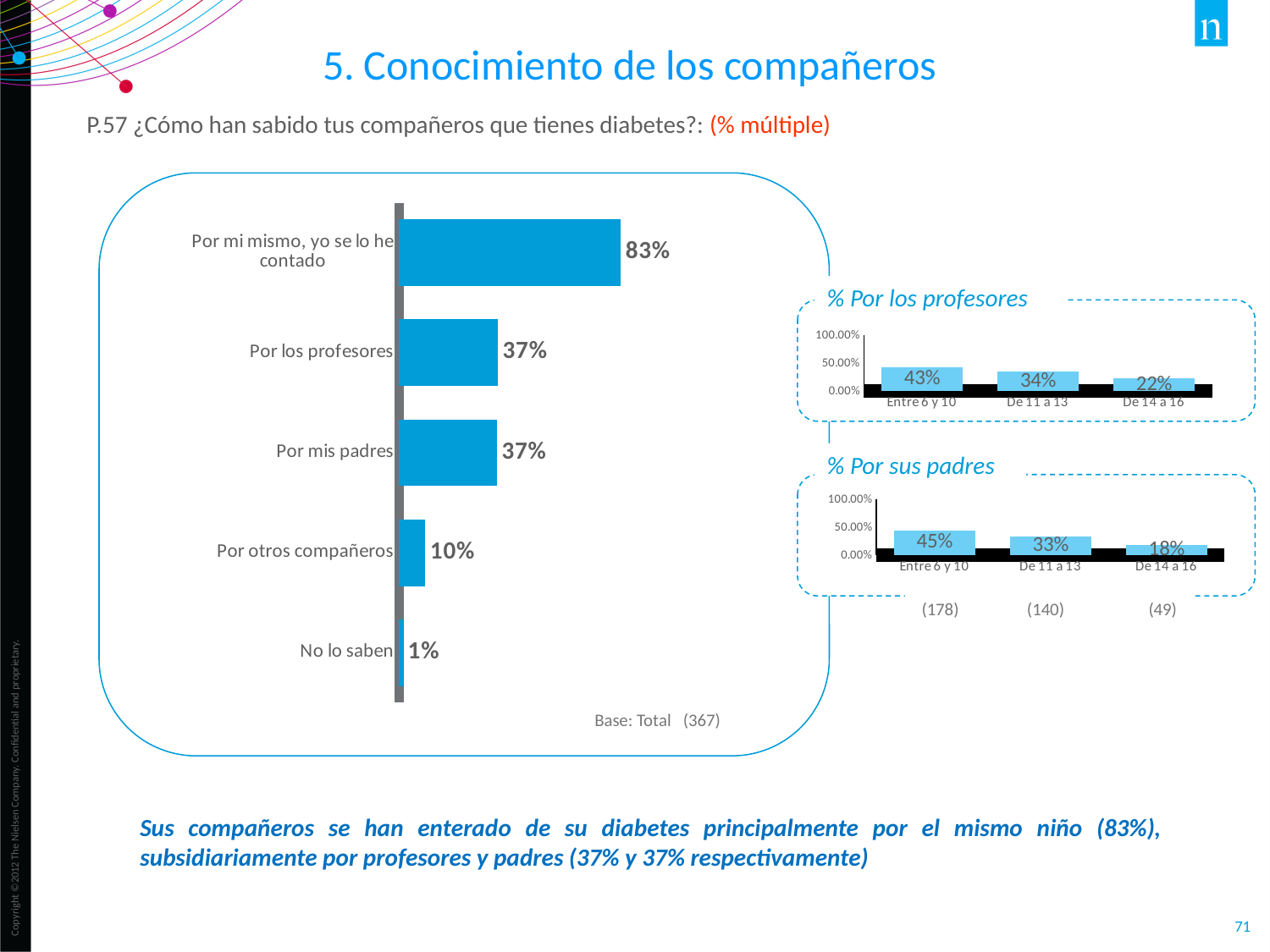
In the '% Por sus padres' chart, which is larger: 'Entre 6 y 10' or 'De 11 a 13'? Entre 6 y 10 In the main horizontal bar chart on the left, which category has the lowest value? No lo saben In the main horizontal bar chart on the left, what is the value for 'Por mi mismo, yo se lo he contado'? 83% In the '% Por sus padres' chart, what is the value for 'De 14 a 16'? 18% In the main horizontal bar chart on the left, which category has the highest value? Por mi mismo, yo se lo he contado In the '% Por los profesores' chart, what is the value for 'Entre 6 y 10'? 43% In the main horizontal bar chart on the left, what is the value for 'Por otros compañeros'? 10% How many categories does the main horizontal bar chart on the left show? 5 In the '% Por sus padres' chart, what is the difference between 'Entre 6 y 10' and 'De 14 a 16'? 27% In the '% Por los profesores' chart, do the values rise or fall from 'Entre 6 y 10' to 'De 14 a 16'? Fall What kind of chart is the main chart on the left? Bar chart In the main horizontal bar chart on the left, what is the difference between 'Por mi mismo, yo se lo he contado' and 'Por los profesores'? 46%